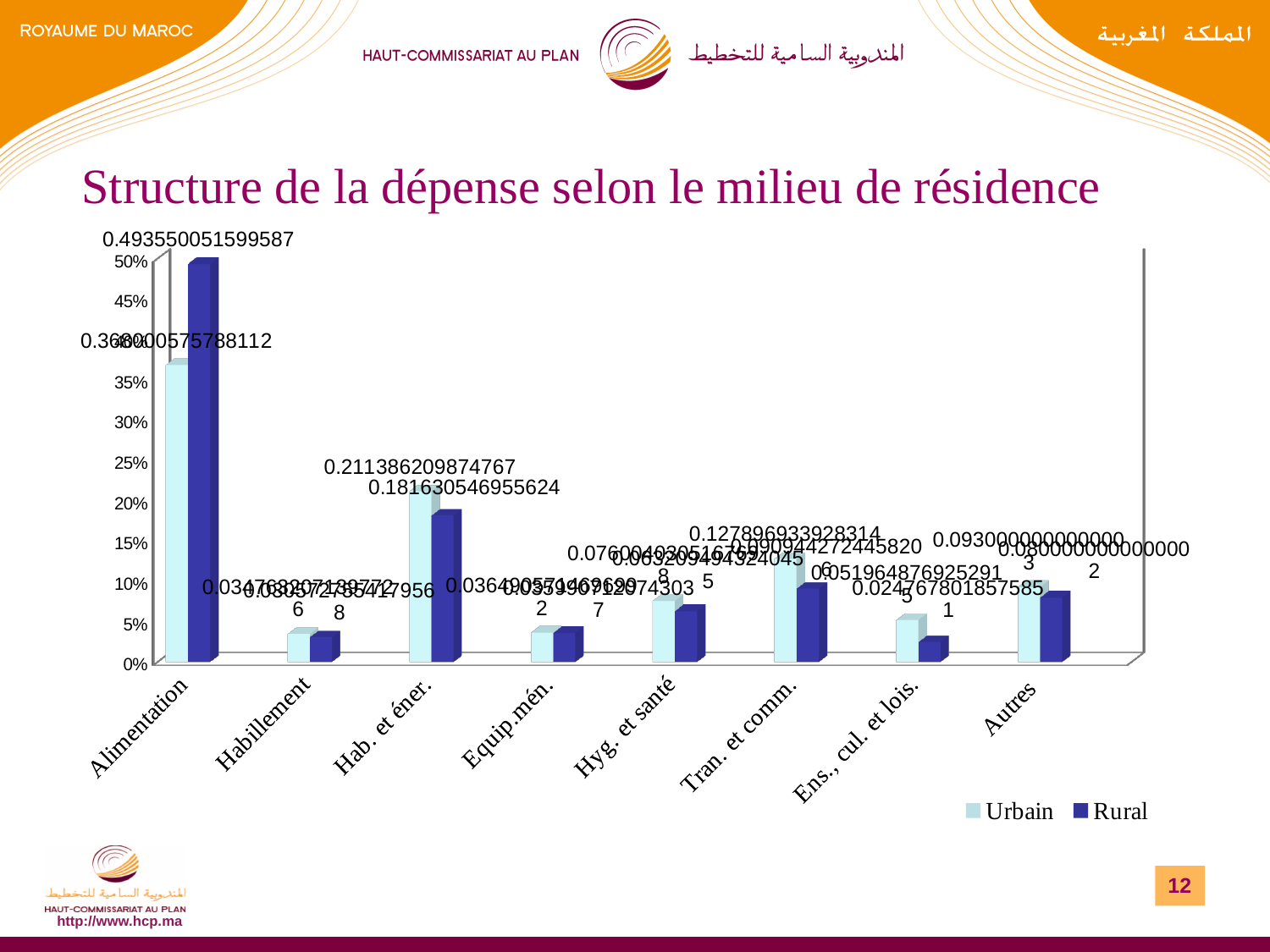
Which category has the highest Rural value? Alimentation How many series does the legend list? 2 Which category has the lowest Rural value? Ens., cul. et lois. Is the Urbain value for Tran. et comm. greater or less than 10%? greater Is the Urbain value for Alimentation greater or less than 35%? greater Is the Rural value for Ens., cul. et lois. greater or less than 5%? less For Alimentation, which is larger, the Urbain value or the Rural value? Rural How many categories are shown on the x axis? 8 What is the title of the chart? Structure de la dépense selon le milieu de résidence For Hab. et éner., which is larger, the Urbain value or the Rural value? Urbain What kind of chart is shown on the slide? bar chart